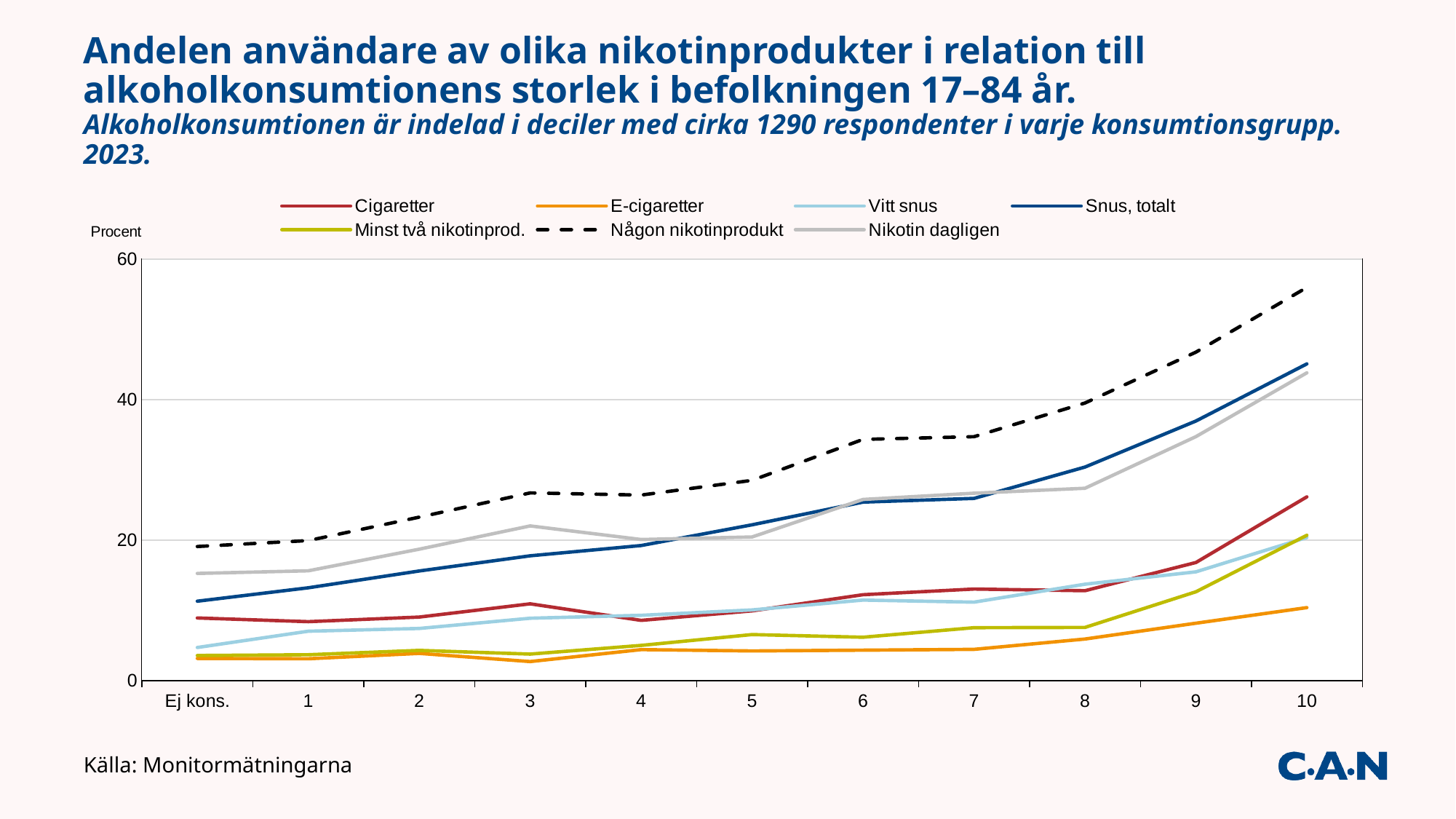
At category 10, which is larger: Snus, totalt or Cigaretter? Snus, totalt Does the Någon nikotinprodukt line rise or fall from Ej kons. to 10? Rise Which series has the highest value at category 10? Någon nikotinprodukt Is the value for Snus, totalt at Ej kons. greater or less than 20? less What kind of chart is shown on the slide? Line chart Is the value for Någon nikotinprodukt at category 6 greater or less than 40? less How many categories are shown along the x axis? 11 Which series has the lowest value at category 10? E-cigaretter How many series does the legend list? 7 Is the value for Någon nikotinprodukt at category 10 greater or less than 40? greater Which series is drawn with a dashed line? Någon nikotinprodukt